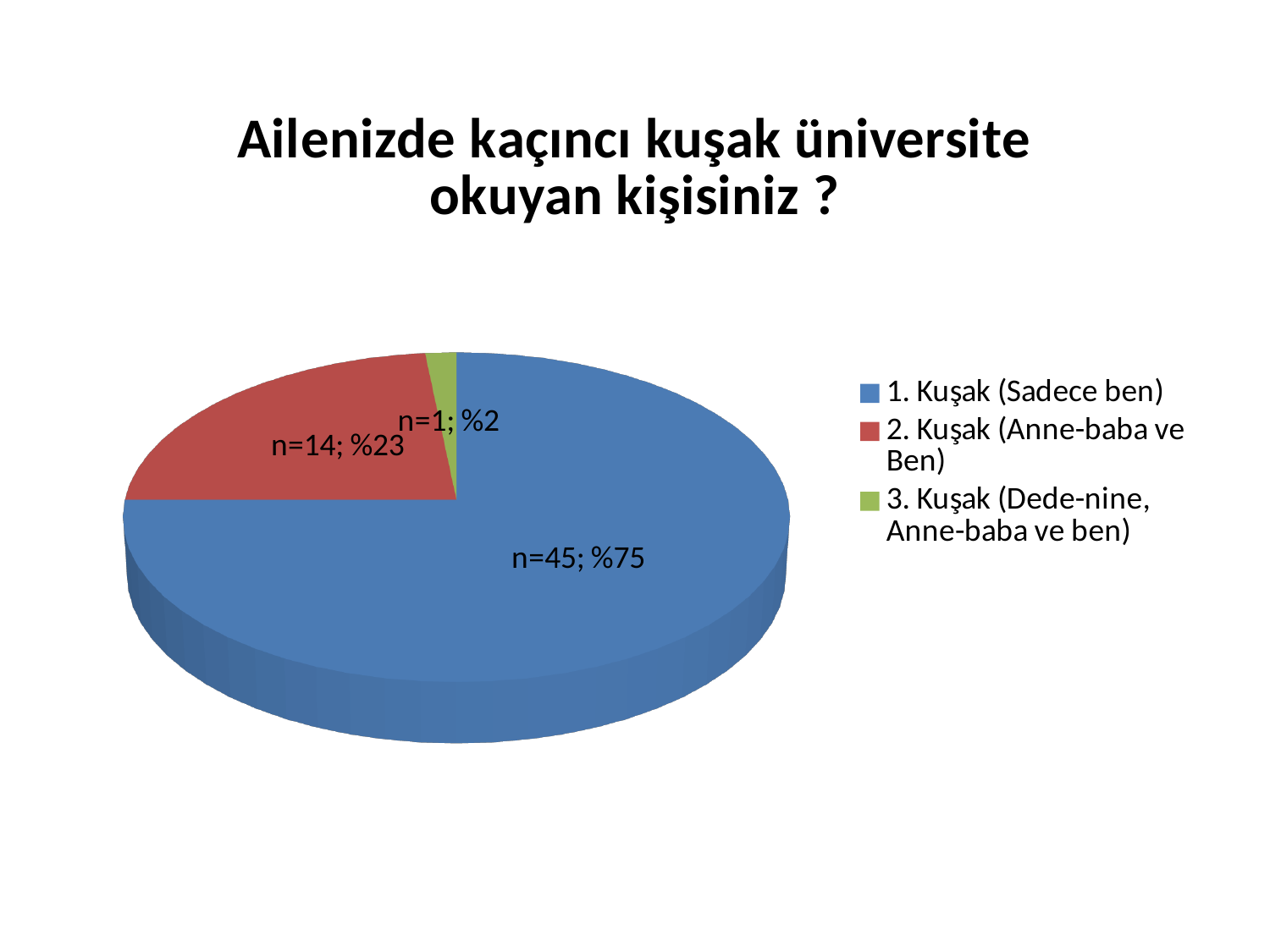
Which has a larger count: '2. Kuşak (Anne-baba ve Ben)' or '3. Kuşak (Dede-nine, Anne-baba ve ben)'? 2. Kuşak (Anne-baba ve Ben) What colour is the '2. Kuşak (Anne-baba ve Ben)' slice? red Which category has the smallest slice? 3. Kuşak (Dede-nine, Anne-baba ve ben) How many slices does the pie chart have? 3 What is the difference in count (n) between '1. Kuşak (Sadece ben)' and '2. Kuşak (Anne-baba ve Ben)'? 31 What kind of chart is shown on the slide? pie chart What percentage share does the '1. Kuşak (Sadece ben)' slice have? %75 What percentage share does the '2. Kuşak (Anne-baba ve Ben)' slice have? %23 Which category has the largest slice? 1. Kuşak (Sadece ben) What is the total count (n) across all three slices? 60 What is the count (n) for the '1. Kuşak (Sadece ben)' slice? n=45 What is the count (n) for the '3. Kuşak (Dede-nine, Anne-baba ve ben)' slice? n=1